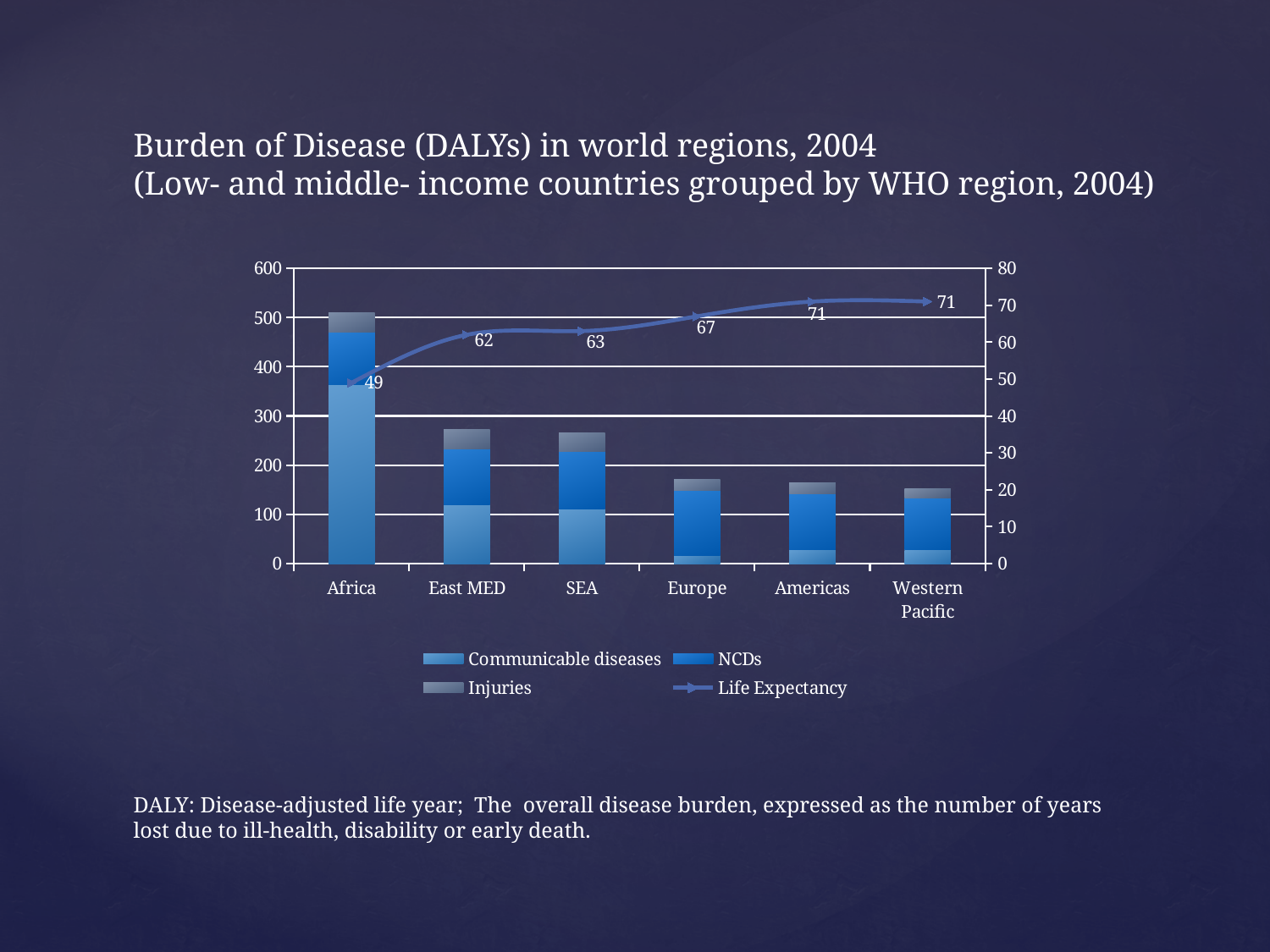
How many regions are shown on the x axis? 6 Does the life expectancy line generally rise or fall from Africa to Western Pacific? rise What is the life expectancy value shown for Africa? 49 What is the life expectancy value shown for SEA? 63 Is the total DALY bar for Africa greater or less than 400? greater How many series does the legend list? 4 Which series is plotted as a line rather than as bars? Life Expectancy What is the difference between the life expectancy values for Europe and Africa? 18 What is the life expectancy value shown for Europe? 67 Which region has the taller total DALY bar, Africa or East MED? Africa Is the total DALY bar for Europe greater or less than 200? less Which region has the lowest life expectancy on the chart? Africa